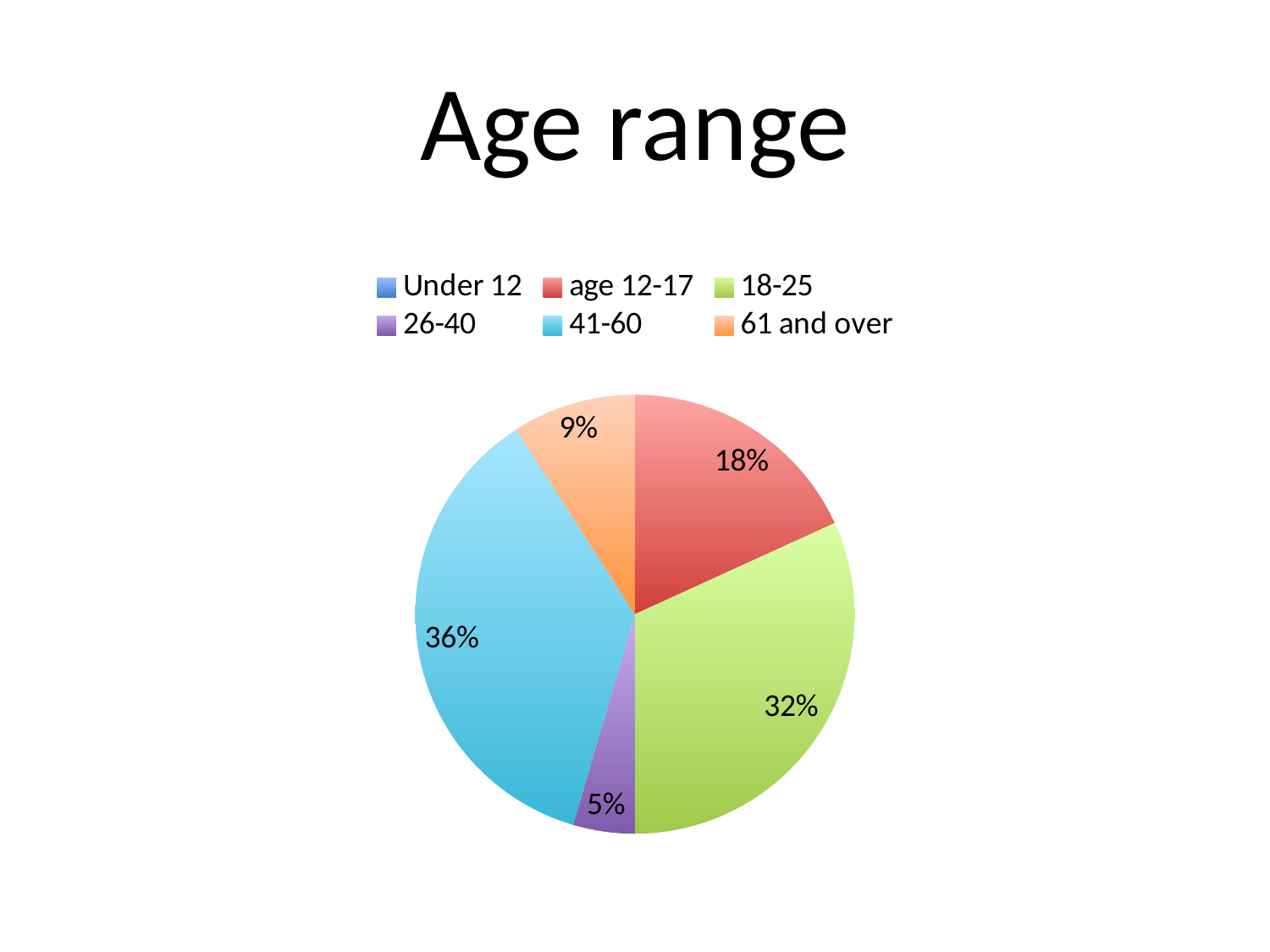
Which slice is larger, age 12-17 or 61 and over? age 12-17 What is the title of the chart? Age range How many categories does the legend list? 6 What percentage of the pie is the 41-60 slice? 36% What kind of chart is shown on the slide? pie chart What percentage of the pie is the 18-25 slice? 32% What percentage of the pie is the 61 and over slice? 9% What is the difference in percentage points between the 41-60 slice and the 18-25 slice? 4 What percentage of the pie is the 26-40 slice? 5% What percentage of the pie is the age 12-17 slice? 18% Which age range has the largest share of the pie? 41-60 Which age range with a labelled slice has the smallest share of the pie? 26-40